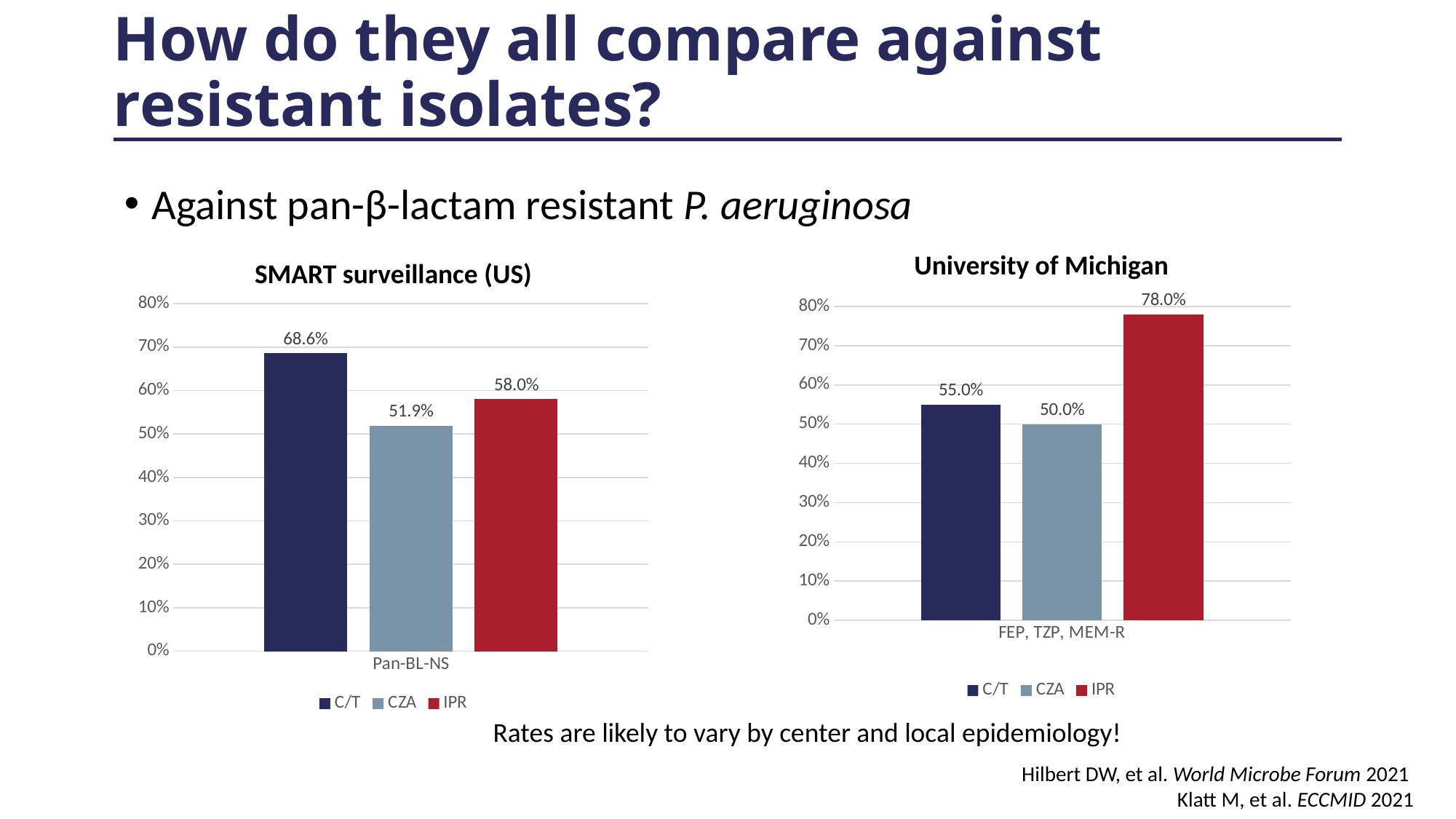
What is the category label on the x axis of the University of Michigan chart? FEP, TZP, MEM-R In the University of Michigan chart, what is the difference between the IPR and C/T values? 23.0% In the SMART surveillance (US) chart, what is the value for CZA? 51.9% What kind of chart is the University of Michigan chart? Bar chart In the University of Michigan chart, what is the value for IPR? 78.0% In the University of Michigan chart, what is the value for CZA? 50.0% In the University of Michigan chart, which series has the lowest value? CZA In the SMART surveillance (US) chart, which series has the highest value? C/T In the SMART surveillance (US) chart, what is the difference between the C/T and IPR values? 10.6% How many series does the legend of the SMART surveillance (US) chart list? 3 In the SMART surveillance (US) chart, what is the value for C/T? 68.6% In the University of Michigan chart, which is larger, the value for C/T or the value for IPR? IPR